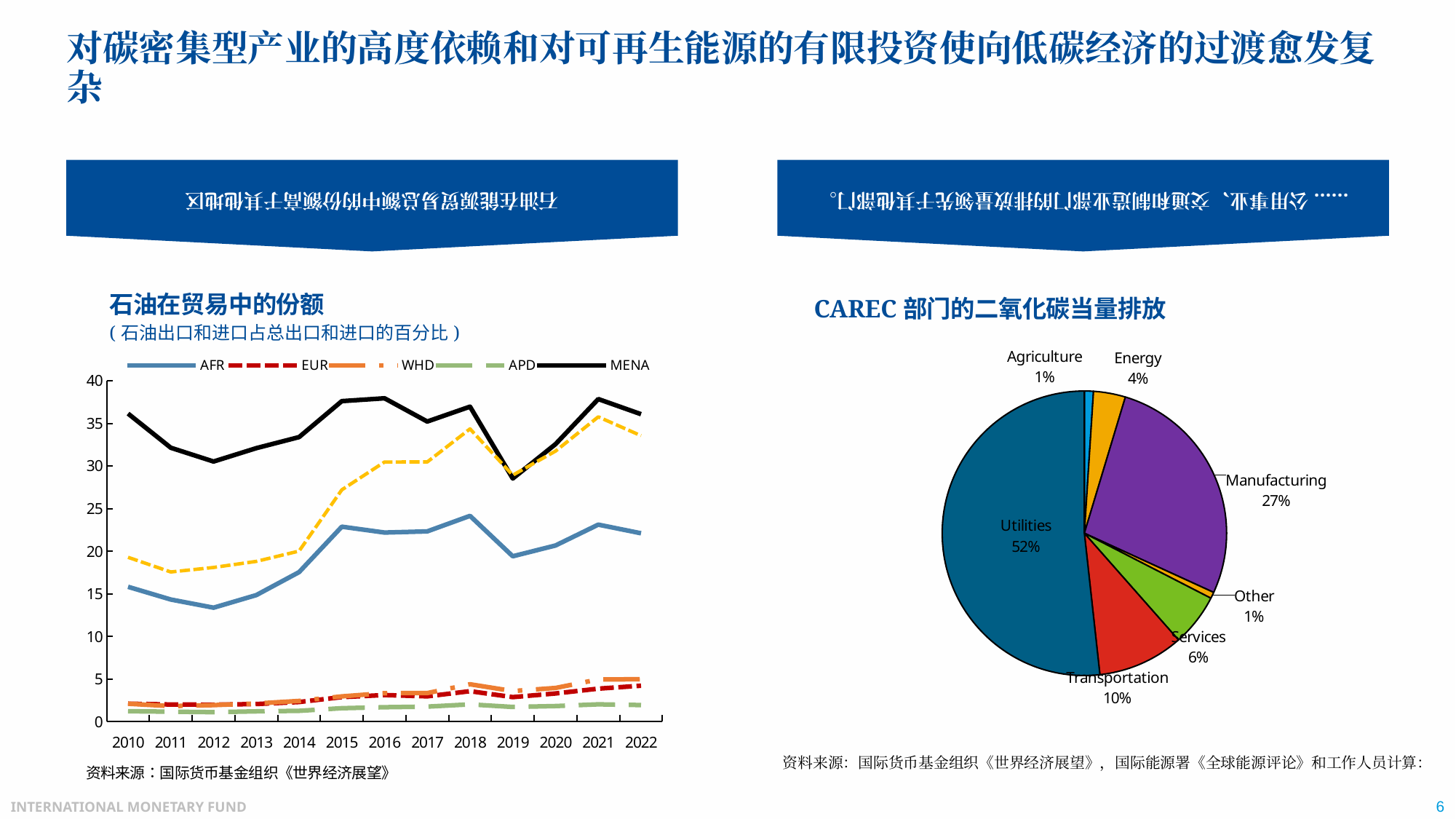
In the pie chart 'CAREC 部门的二氧化碳当量排放', how many percentage points larger is Manufacturing than Transportation? 17 percentage points In the line chart '石油在贸易中的份额', how many years are shown on the x axis? 13 In the pie chart 'CAREC 部门的二氧化碳当量排放', which sector has the largest share? Utilities In the pie chart 'CAREC 部门的二氧化碳当量排放', what share of emissions comes from Utilities? 52% What kind of chart is the chart on the left of the slide, '石油在贸易中的份额'? Line chart In the pie chart 'CAREC 部门的二氧化碳当量排放', which is larger, Services or Energy? Services In the pie chart 'CAREC 部门的二氧化碳当量排放', what is the share for Manufacturing? 27% In the line chart '石油在贸易中的份额', which series has the highest value in 2010? MENA In the line chart '石油在贸易中的份额', is the value for MENA in 2010 greater or less than 35? greater What kind of chart is the chart on the right of the slide, 'CAREC 部门的二氧化碳当量排放'? Pie chart In the line chart '石油在贸易中的份额', is the value for AFR in 2012 greater or less than 15? less In the pie chart 'CAREC 部门的二氧化碳当量排放', how many sectors (slices) are shown? 7